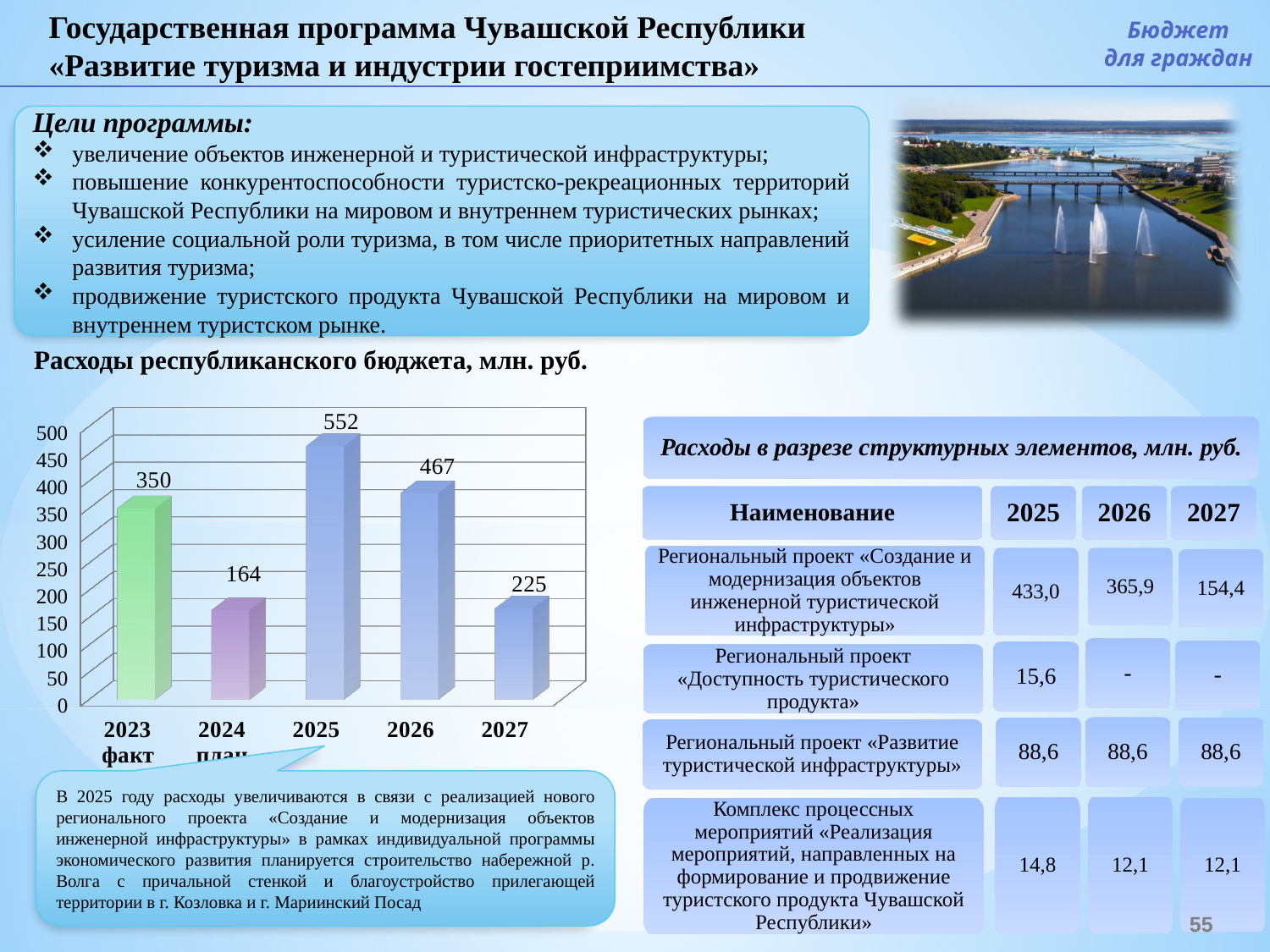
What is the difference between the values for 2025 and 2026 in the chart? 85 Which year has the highest value in the chart? 2025 What is the title of the chart on the slide? Расходы республиканского бюджета, млн. руб. Which is larger in the chart: the value for 2026 or the value for 2027? 2026 Which year has the lowest value in the chart? 2024 план What is the difference between the values for 2023 факт and 2024 план in the chart? 186 How many years (categories) are shown in the chart? 5 What kind of chart is shown on the slide? bar chart What is the value for 2027 in the chart? 225 What is the value for 2023 факт in the chart? 350 What is the value for 2025 in the chart "Расходы республиканского бюджета, млн. руб."? 552